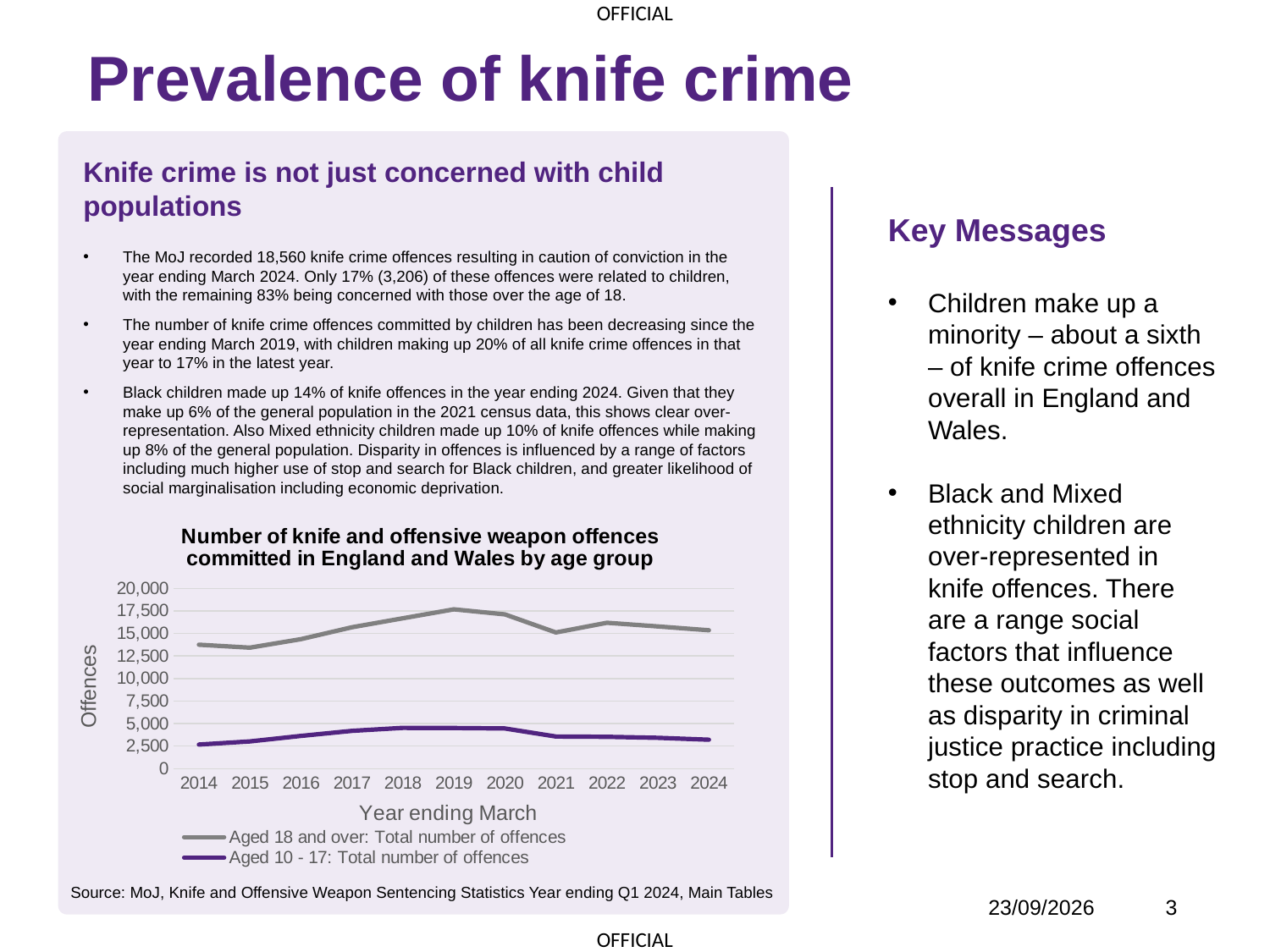
Is the value for 'Aged 10 - 17: Total number of offences' in 2024 greater or less than 5,000? less Does the 'Aged 10 - 17: Total number of offences' line rise or fall between 2020 and 2024? Fall In which year does the 'Aged 18 and over: Total number of offences' line reach its highest value? 2019 How many years are plotted along the x axis of the chart? 11 What is the label of the x axis of the chart? Year ending March What kind of chart is shown on the slide? Line chart Is the value for 'Aged 18 and over: Total number of offences' in 2014 greater or less than 15,000? less How many series does the chart legend list? 2 Is the value for 'Aged 18 and over: Total number of offences' in 2019 greater or less than 15,000? greater For 'Aged 18 and over: Total number of offences', which year has the larger value: 2014 or 2019? 2019 Which series has the larger value in 2024: 'Aged 18 and over' or 'Aged 10 - 17'? Aged 18 and over What is the title of the chart? Number of knife and offensive weapon offences committed in England and Wales by age group